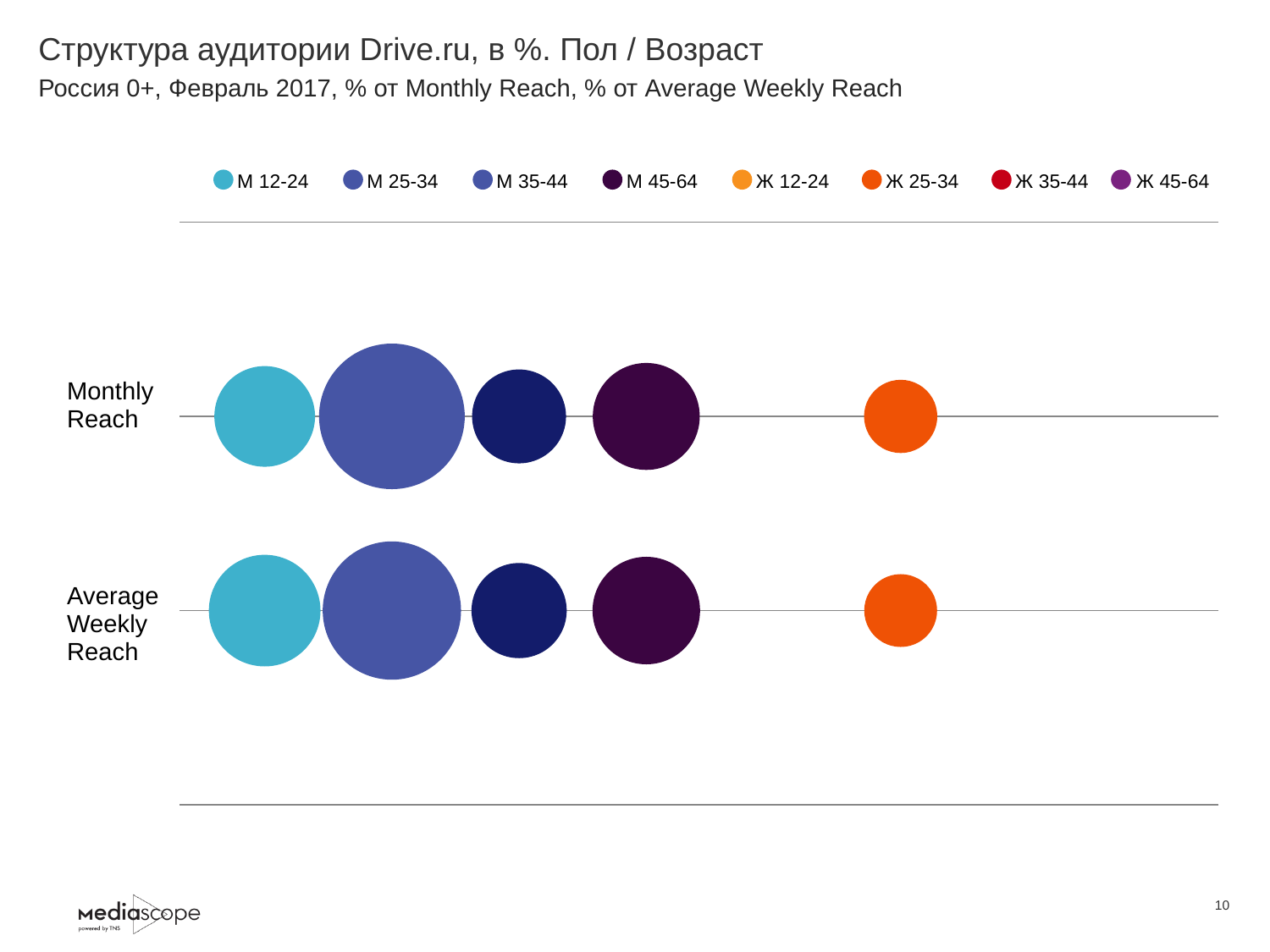
In the Monthly Reach row, which bubble is larger: М 45-64 or М 35-44? М 45-64 Which audience group has the largest bubble in the Monthly Reach row? М 25-34 How many rows (categories) are plotted on the chart? 2 In the Average Weekly Reach row, which bubble is larger: М 12-24 or Ж 25-34? М 12-24 What are the labels of the two rows plotted on the chart? Monthly Reach and Average Weekly Reach What colour is the bubble for Ж 25-34? orange In the Monthly Reach row, which bubble is larger: М 25-34 or Ж 25-34? М 25-34 What kind of chart is shown on the slide? bubble chart How many series does the legend list? 8 Which audience group has the largest bubble in the Average Weekly Reach row? М 25-34 What is the title of the chart on the slide? Структура аудитории Drive.ru, в %. Пол / Возраст